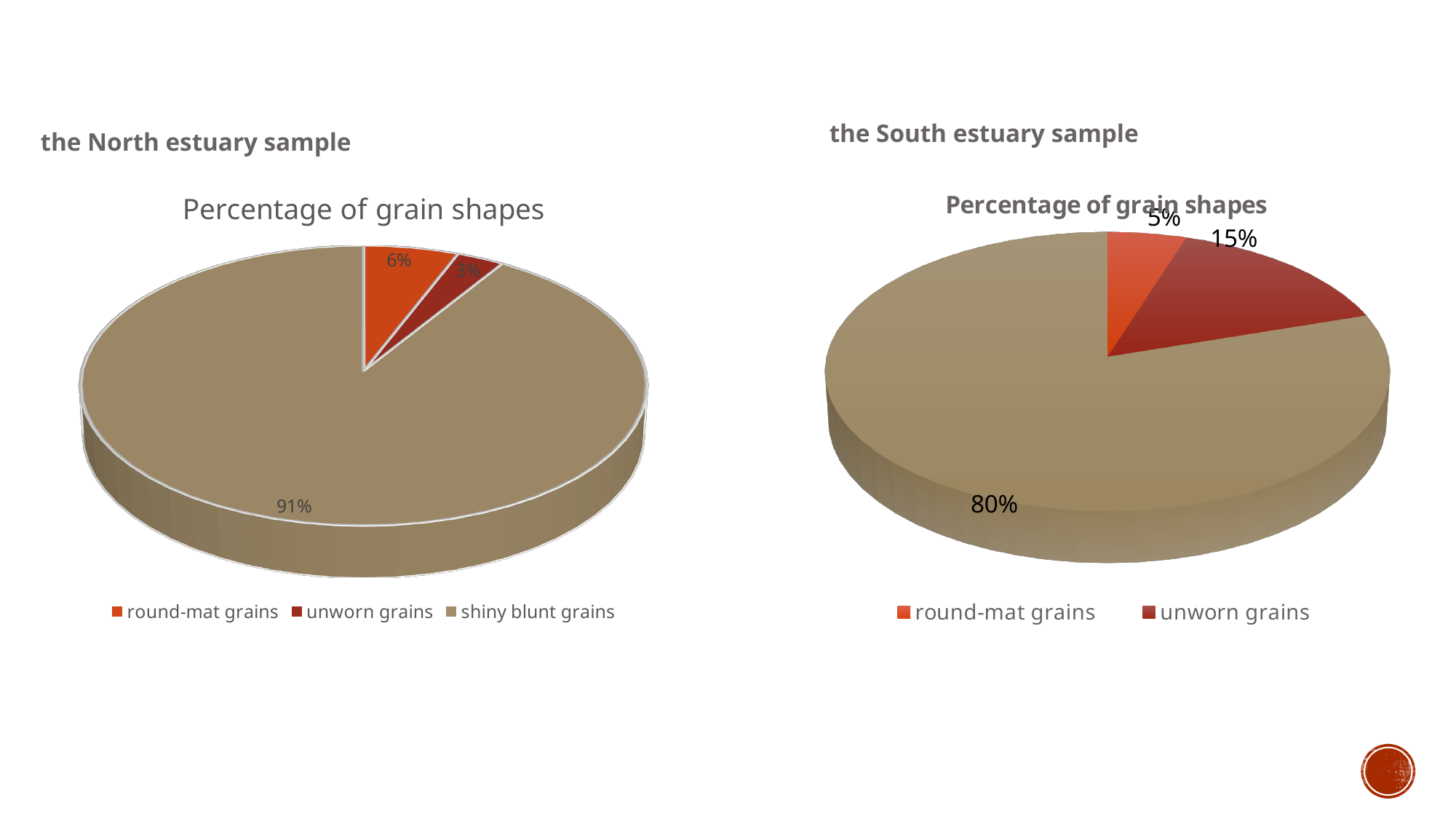
In the North estuary sample chart, which category has the largest share? shiny blunt grains In the North estuary sample chart, what percentage is shown for round-mat grains? 6% What kind of chart is used for the North estuary sample? pie chart In the North estuary sample chart, what is the difference in percentage points between round-mat grains and unworn grains? 3 In the South estuary sample chart, what percentage is shown for unworn grains? 15% How many entries does the legend of the North estuary sample chart list? 3 In the North estuary sample chart, what percentage is shown for unworn grains? 3% In the South estuary sample chart, what percentage is shown on the largest slice? 80% In the North estuary sample chart, what percentage is shown for shiny blunt grains? 91% In the South estuary sample chart, what percentage is shown for round-mat grains? 5% In the South estuary sample chart, which is larger, round-mat grains or unworn grains? unworn grains In the North estuary sample chart, which category has the smallest share? unworn grains